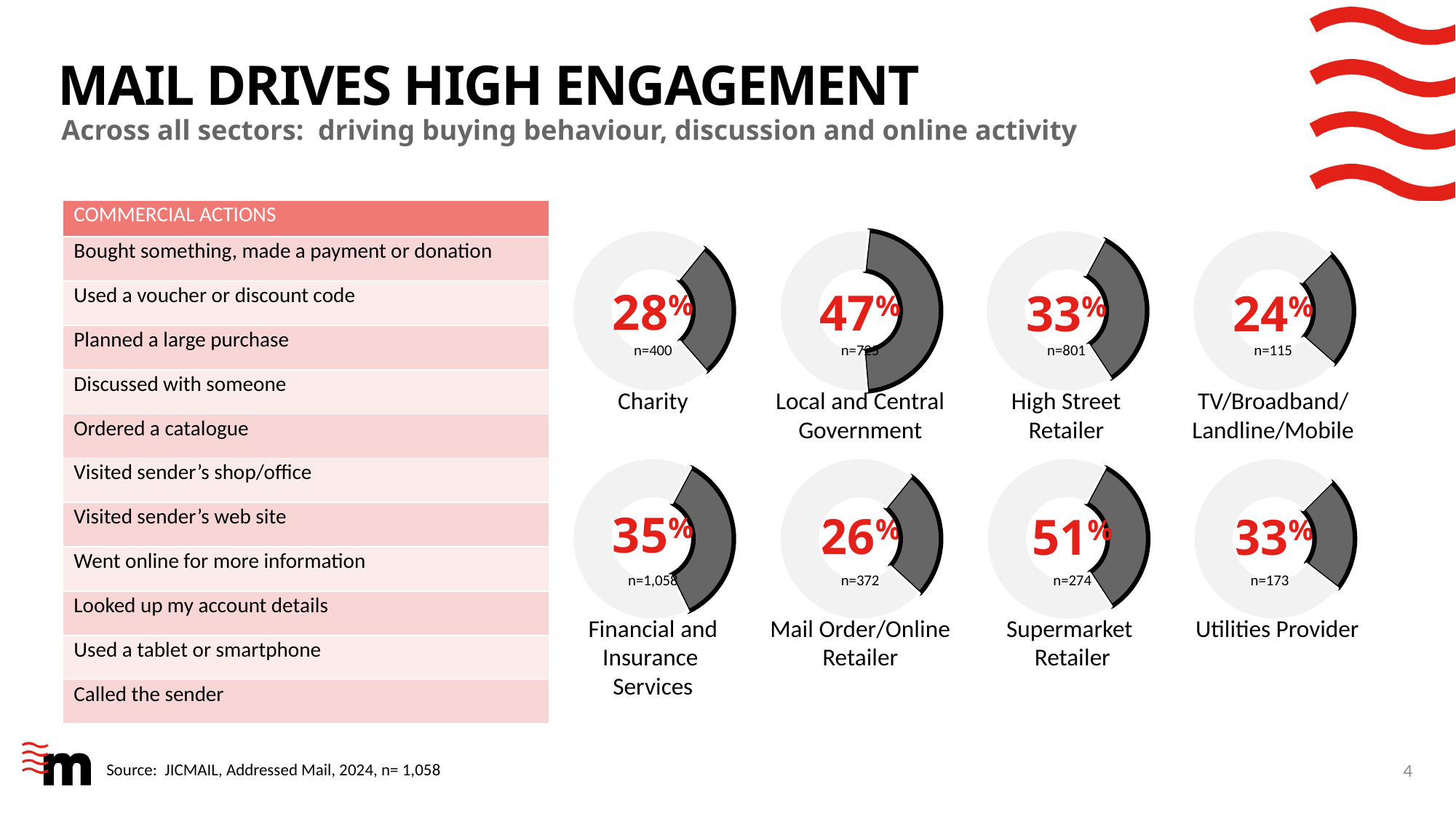
What percentage is shown in the Supermarket Retailer donut chart? 51% Which sector's donut chart shows the highest percentage? Supermarket Retailer What kind of chart is used to show the percentage for each sector? Donut chart What is the difference between the Supermarket Retailer percentage and the Mail Order/Online Retailer percentage? 25% What is the sample size (n) shown in the Financial and Insurance Services donut chart? n=1,058 What percentage is shown in the Charity donut chart? 28% What percentage is shown in the TV/Broadband/Landline/Mobile donut chart? 24% Which is larger, the percentage for High Street Retailer or the percentage for Charity? High Street Retailer What percentage is shown in the Financial and Insurance Services donut chart? 35% How many donut charts are shown on the slide? 8 Which sector's donut chart shows the lowest percentage? TV/Broadband/Landline/Mobile What percentage is shown in the Local and Central Government donut chart? 47%